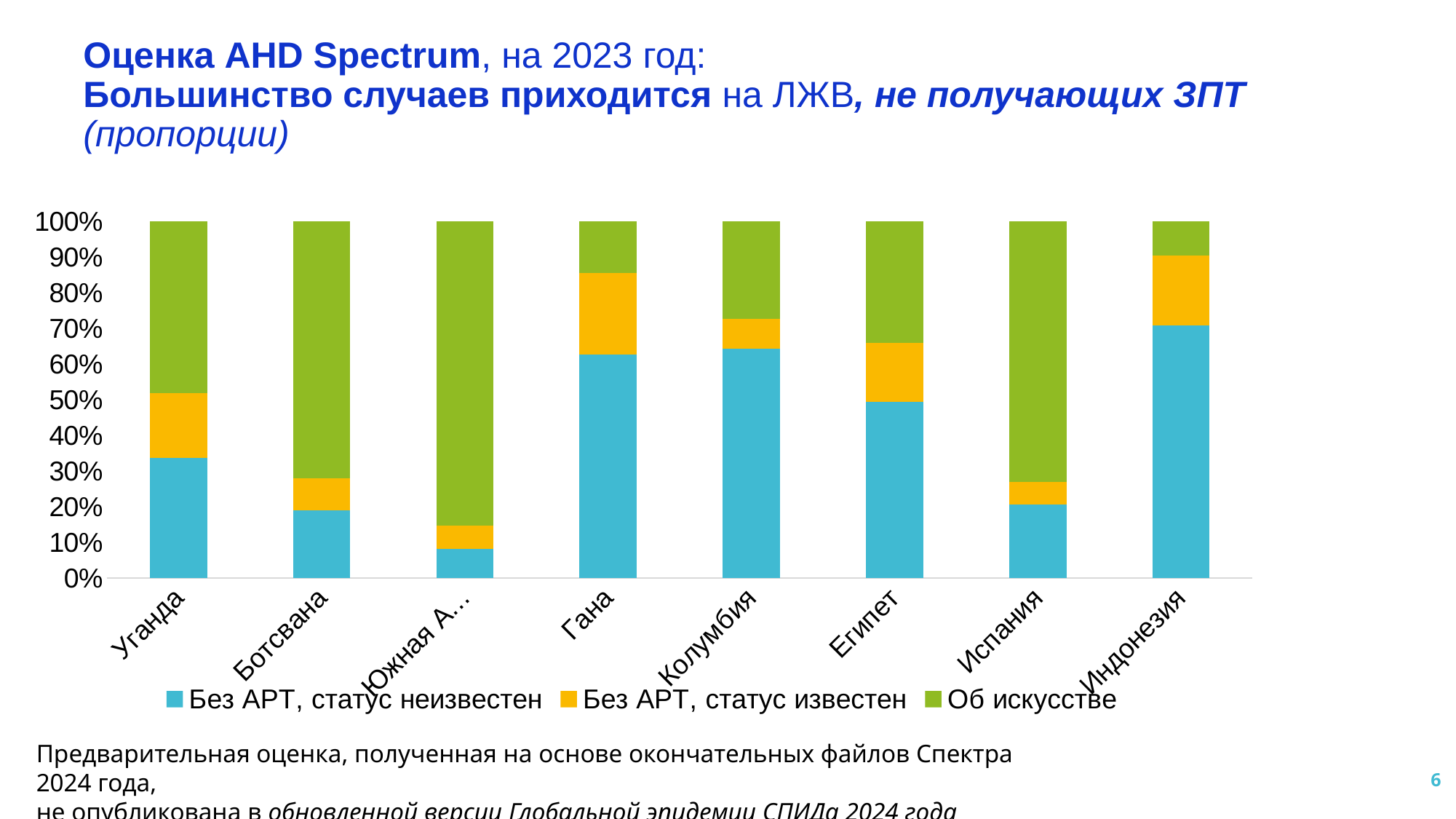
Is the 'Без АРТ, статус неизвестен' value for Уганда greater or less than 30%? greater What does each stacked bar in the chart total? 100% Is the 'Без АРТ, статус неизвестен' value for Египет greater or less than 40%? greater Which colour represents 'Об искусстве' in the chart legend? Green Which country has the largest 'Без АРТ, статус неизвестен' segment? Индонезия Is the 'Без АРТ, статус неизвестен' value for Гана greater or less than 60%? greater What kind of chart is shown on the slide? Stacked bar chart How many countries are shown on the x axis of the chart? 8 Which has the larger 'Без АРТ, статус неизвестен' share, Гана or Ботсвана? Гана How many series does the chart legend list? 3